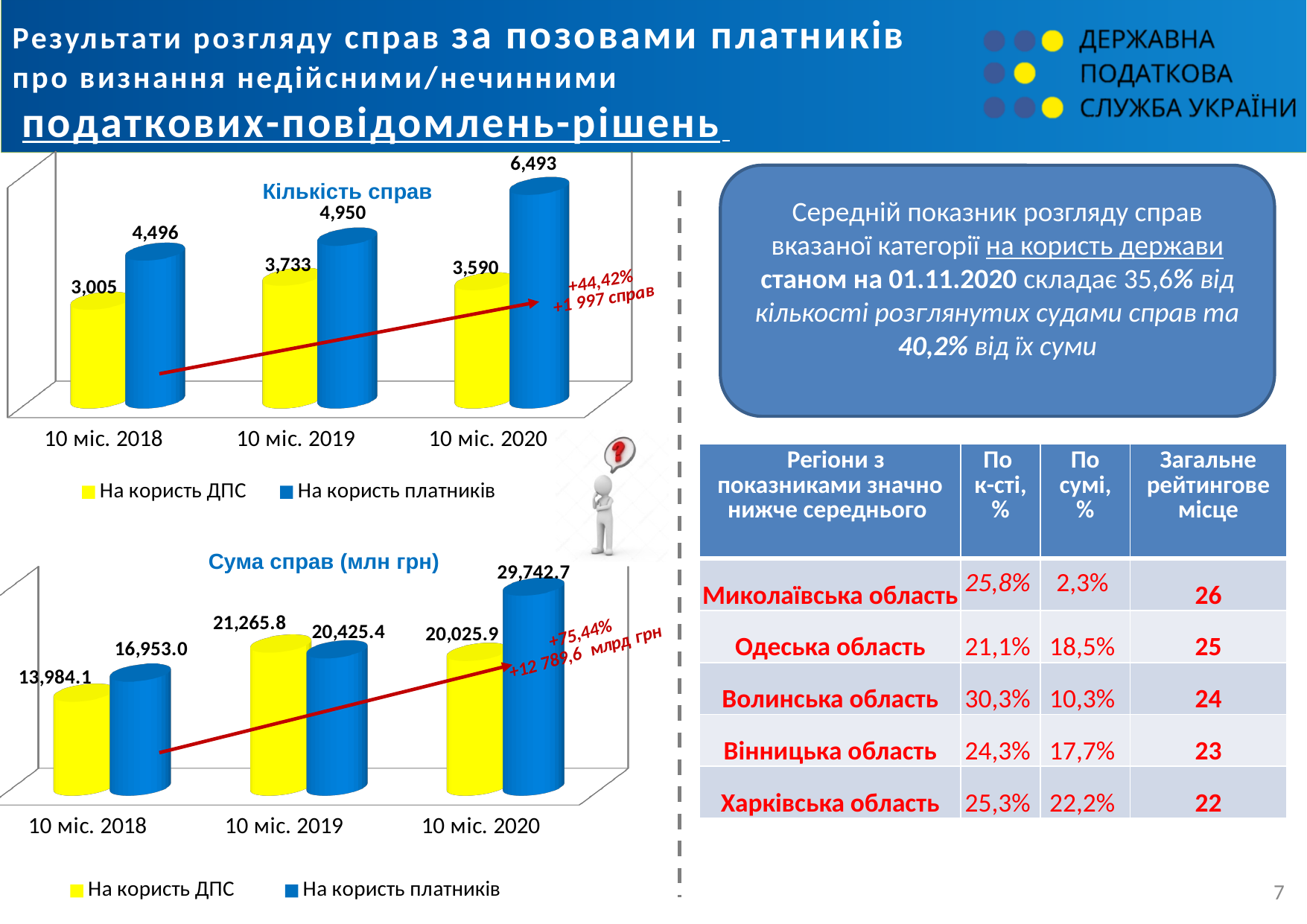
In the 'Сума справ (млн грн)' chart, which period has the lowest value for 'На користь платників'? 10 міс. 2018 In the 'Кількість справ' chart, what is the value for 'На користь платників' in 10 міс. 2020? 6,493 In the 'Сума справ (млн грн)' chart, what is the value for 'На користь платників' in 10 міс. 2020? 29,742.7 In the 'Сума справ (млн грн)' chart, what is the value for 'На користь ДПС' in 10 міс. 2019? 21,265.8 In the 'Кількість справ' chart, what is the difference between 'На користь платників' and 'На користь ДПС' in 10 міс. 2020? 2,903 In the 'Кількість справ' chart, which period has the highest value for 'На користь ДПС'? 10 міс. 2019 In the 'Кількість справ' chart, how many series does the legend list? 2 In the 'Сума справ (млн грн)' chart, which is larger in 10 міс. 2019: 'На користь ДПС' or 'На користь платників'? На користь ДПС In the 'Сума справ (млн грн)' chart, does the value for 'На користь платників' rise or fall from 10 міс. 2018 to 10 міс. 2020? rise What type of chart is the 'Кількість справ' chart? bar chart In the 'Сума справ (млн грн)' chart, how many periods are shown on the x axis? 3 In the 'Кількість справ' chart, what is the value for 'На користь ДПС' in 10 міс. 2018? 3,005